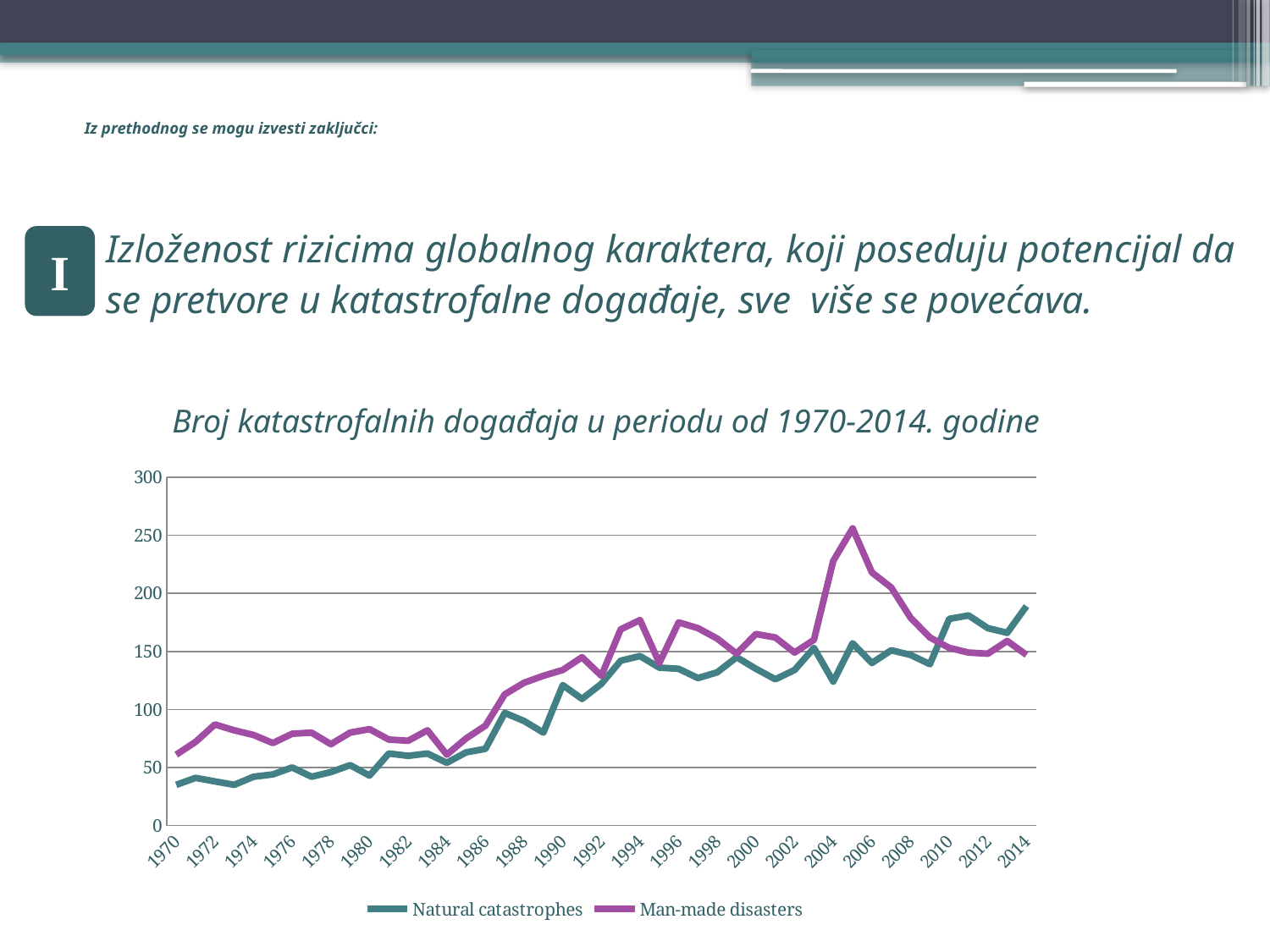
What kind of chart is shown on the slide? line chart Which two series are listed in the chart's legend? Natural catastrophes and Man-made disasters Does the Man-made disasters line reach its highest value before or after 2000? after In 1980, which series has the higher value, Natural catastrophes or Man-made disasters? Man-made disasters Is the peak value of the Man-made disasters line greater or less than 200? greater In 2014, which series has the higher value, Natural catastrophes or Man-made disasters? Natural catastrophes Is the value for Natural catastrophes in 2010 greater or less than 150? greater How many series does the chart's legend list? 2 Is the value for Man-made disasters in 1972 greater or less than 100? less Overall, does the Natural catastrophes line rise or fall from 1970 to 2014? rise What is the title of the chart? Broj katastrofalnih događaja u periodu od 1970-2014. godine